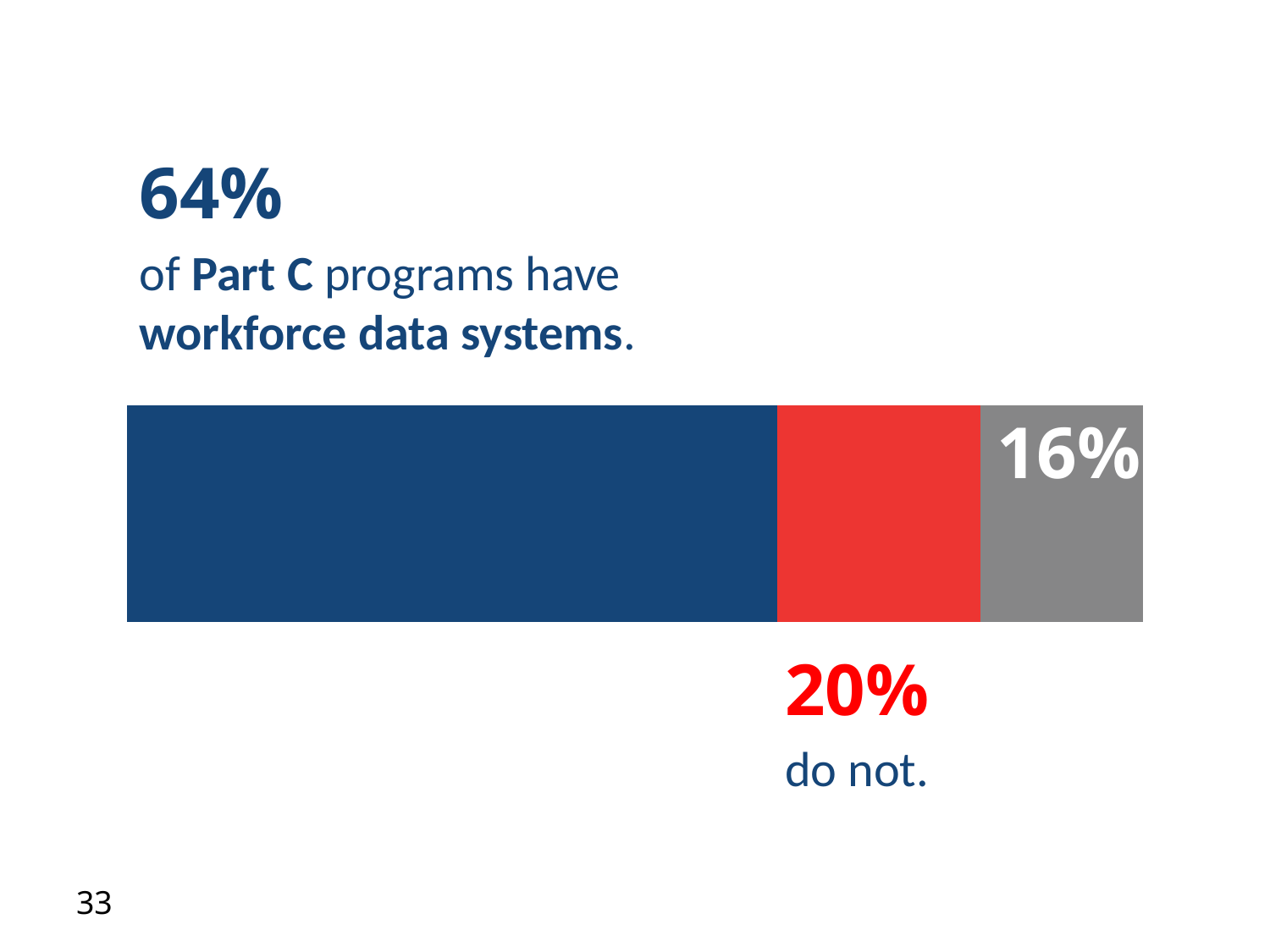
What percentage of Part C programs do not have workforce data systems? 20% What value is printed on the gray segment of the bar? 16% What is the total of the three segments in the stacked bar? 100% What colour is the segment representing Part C programs that have workforce data systems? Dark blue What percentage of Part C programs have workforce data systems? 64% What is the difference between the share of Part C programs that have workforce data systems and the share that do not? 44 percentage points Which segment of the bar has the largest value? 64% (have workforce data systems) What kind of chart is shown on the slide? A stacked horizontal bar chart Which is larger: the share that do not have workforce data systems or the gray segment? The share that do not (20%) What is the difference between the red segment (20%) and the gray segment (16%)? 4 percentage points Which segment of the bar has the smallest value? 16% (gray segment) How many segments does the stacked bar contain? 3